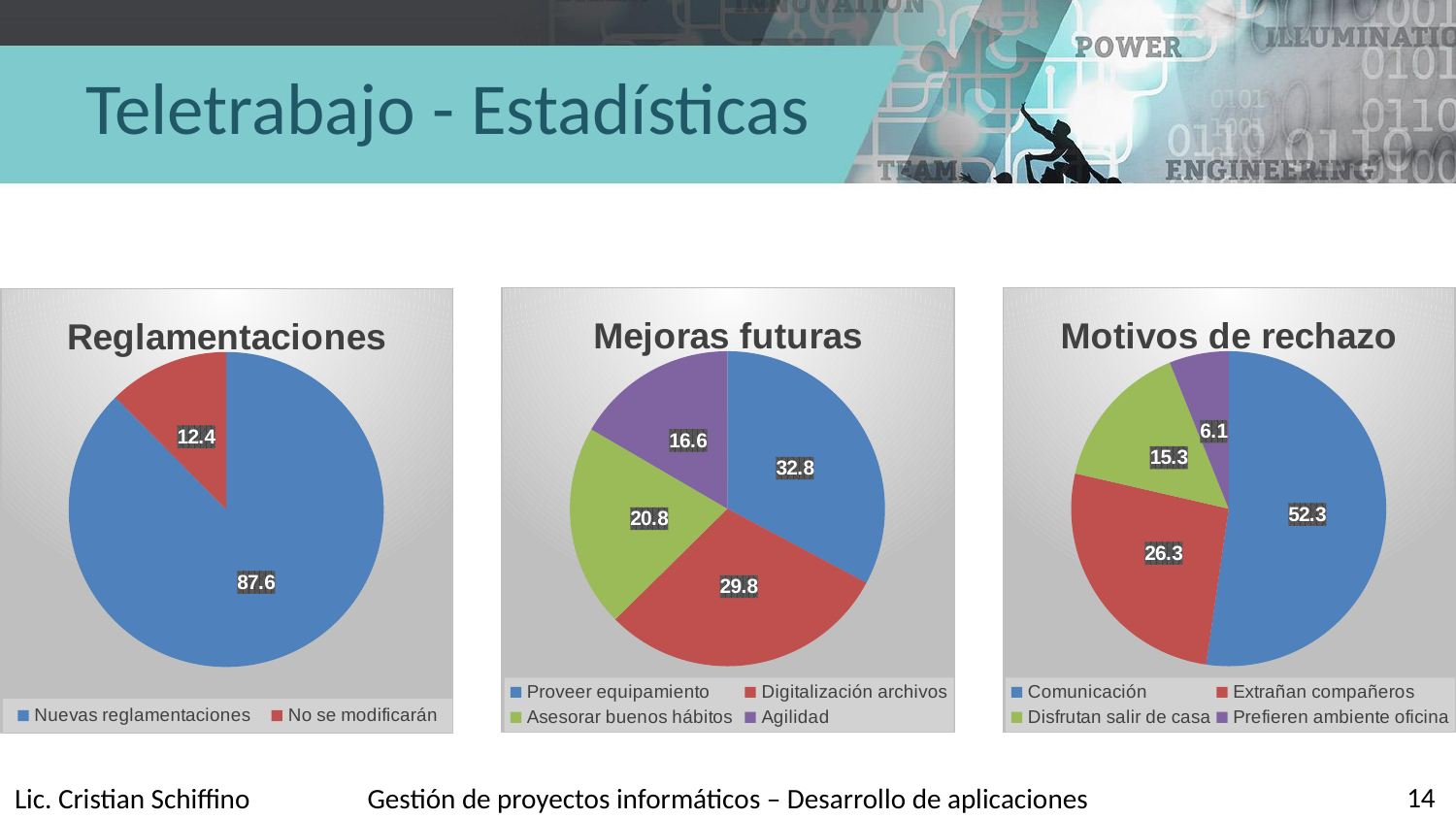
In the 'Reglamentaciones' chart, what is the difference between 'Nuevas reglamentaciones' and 'No se modificarán'? 75.2 In the 'Motivos de rechazo' chart, what is the value for 'Extrañan compañeros'? 26.3 In the 'Motivos de rechazo' chart, which is larger: 'Disfrutan salir de casa' or 'Prefieren ambiente oficina'? Disfrutan salir de casa In the 'Motivos de rechazo' chart, what is the difference between 'Comunicación' and 'Extrañan compañeros'? 26.0 In the 'Mejoras futuras' chart, which category has the largest slice? Proveer equipamiento In the 'Reglamentaciones' chart, what is the value for 'No se modificarán'? 12.4 What kind of chart is the 'Motivos de rechazo' chart? Pie chart In the 'Mejoras futuras' chart, what is the value for 'Digitalización archivos'? 29.8 In the 'Reglamentaciones' chart, what is the value for 'Nuevas reglamentaciones'? 87.6 In the 'Mejoras futuras' chart, how many categories are shown? 4 How many charts are shown on the slide? 3 In the 'Mejoras futuras' chart, which category has the smallest slice? Agilidad